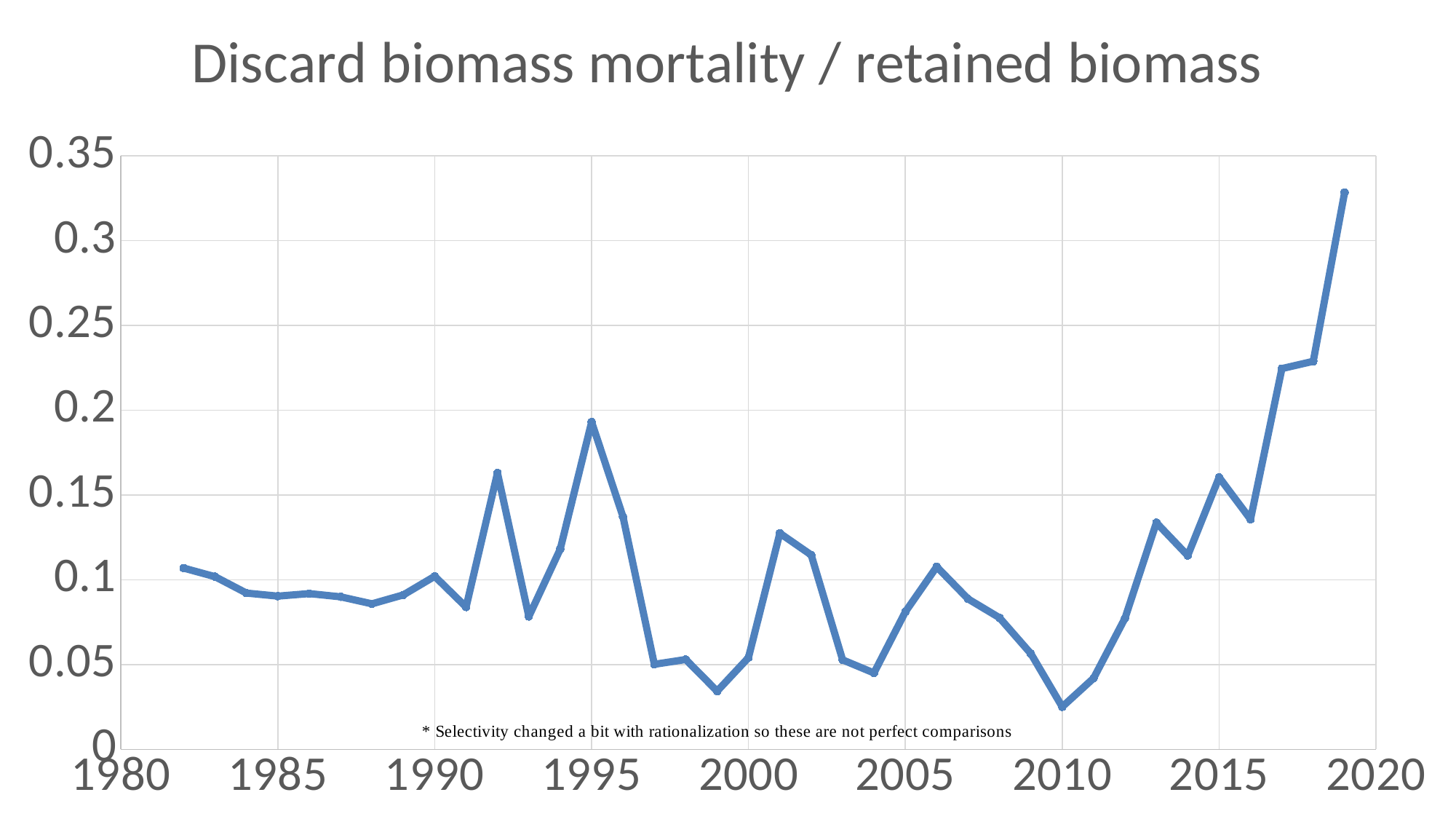
Is the value for 2019 greater or less than 0.3? greater Is the value for 2010 greater or less than 0.05? less What kind of chart is shown on the slide? line chart Does the line generally rise or fall between 2010 and 2019? rise Is the value for 1999 greater or less than 0.05? less Which year has the larger value, 2001 or 2010? 2001 In which year does the line reach its lowest value? 2010 Which year has the larger value, 1992 or 1995? 1995 In which year does the line reach its highest value? 2019 What is the title of the chart? Discard biomass mortality / retained biomass